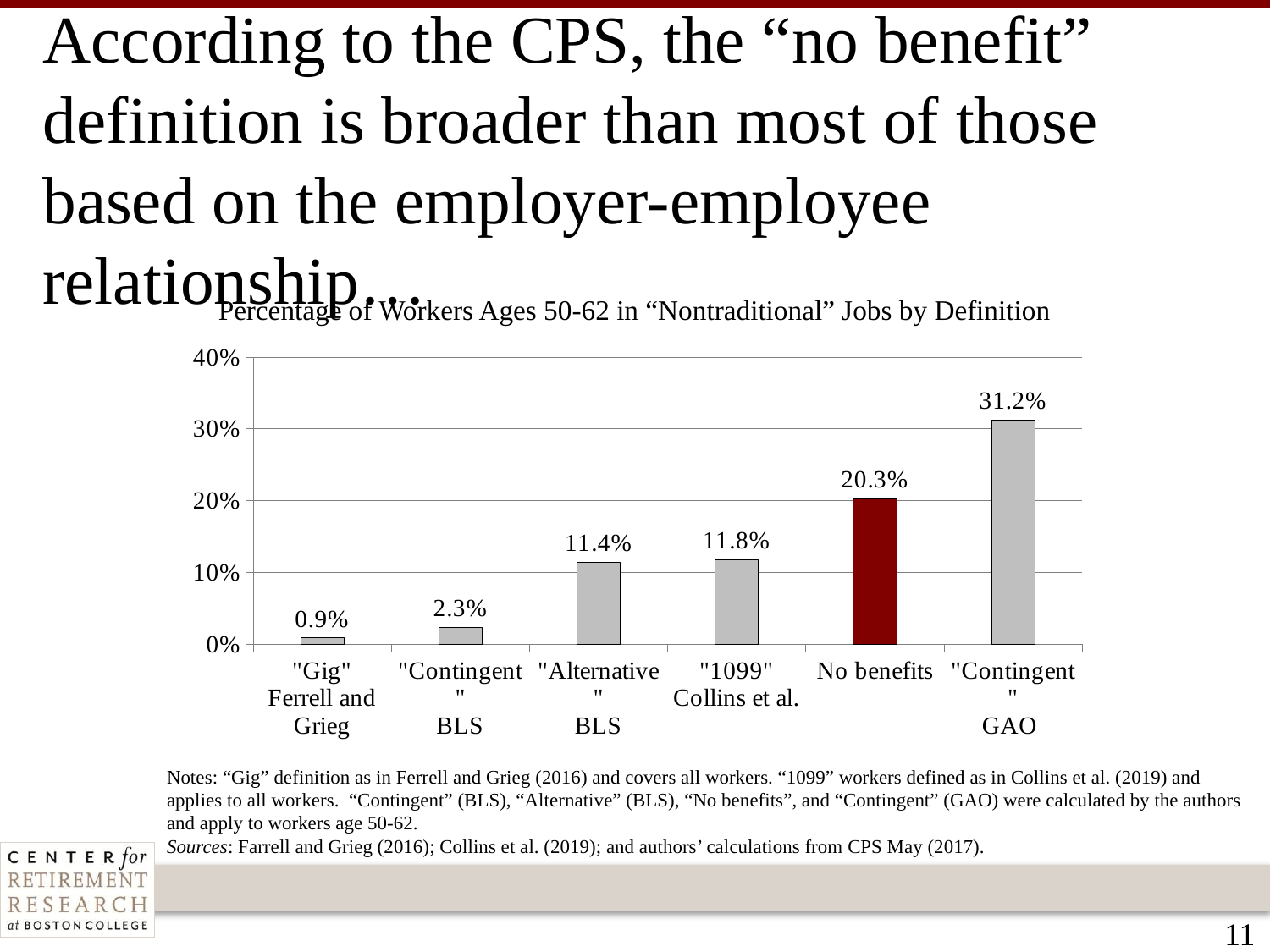
Which bar is shown in a different colour (dark red) from the others? No benefits What is the value for the "Gig" definition from Ferrell and Grieg? 0.9% Which is larger, the "Contingent" BLS value or the "Alternative" BLS value? "Alternative" BLS What kind of chart is shown on the slide? Bar chart Which definition has the highest percentage of workers ages 50-62 in nontraditional jobs? "Contingent" GAO What is the value for the "No benefits" definition? 20.3% What is the difference between the "Contingent" GAO value and the "No benefits" value? 10.9% Which definition has the lowest percentage? "Gig" Ferrell and Grieg How many definitions (bars) are shown in the chart? 6 Do the values rise or fall moving from left to right along the x axis? Rise Is the value for "No benefits" greater or less than 20%? greater What is the value for the "1099" definition from Collins et al.? 11.8%